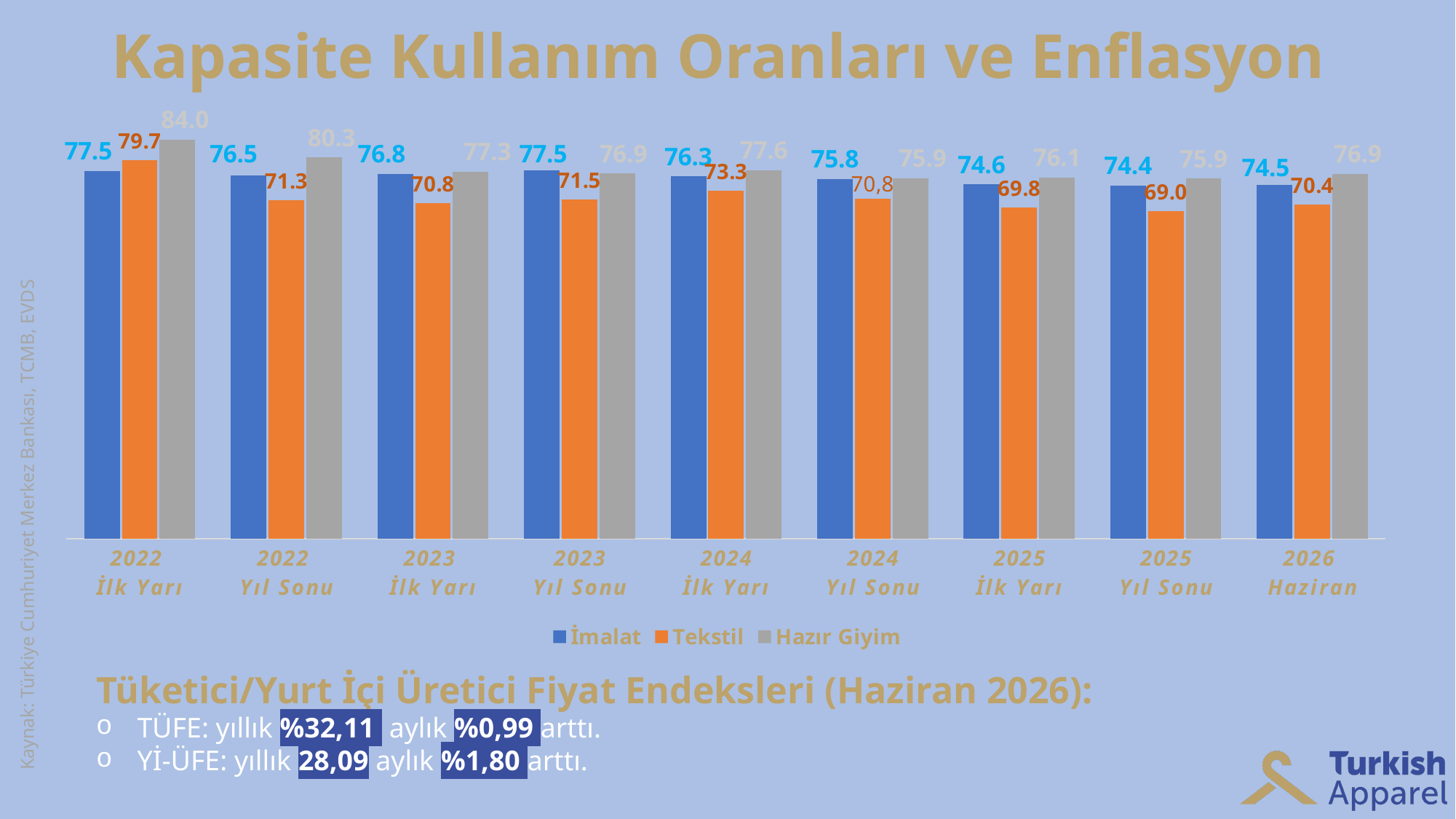
Which is larger for 2024 İlk Yarı: the İmalat value or the Tekstil value? İmalat In which period is the Tekstil value highest? 2022 İlk Yarı Does the İmalat value rise or fall from 2023 Yıl Sonu to 2025 Yıl Sonu? Fall What is the Tekstil value for 2025 Yıl Sonu? 69.0 In which period is the Tekstil value lowest? 2025 Yıl Sonu What is the title of the chart? Kapasite Kullanım Oranları ve Enflasyon What is the İmalat value for 2026 Haziran? 74.5 What is the Hazır Giyim value for 2022 İlk Yarı? 84.0 What kind of chart is shown on the slide? Bar chart What is the difference between the Hazır Giyim and Tekstil values for 2022 Yıl Sonu? 9.0 How many series does the legend list? 3 How many periods are shown on the x axis? 9